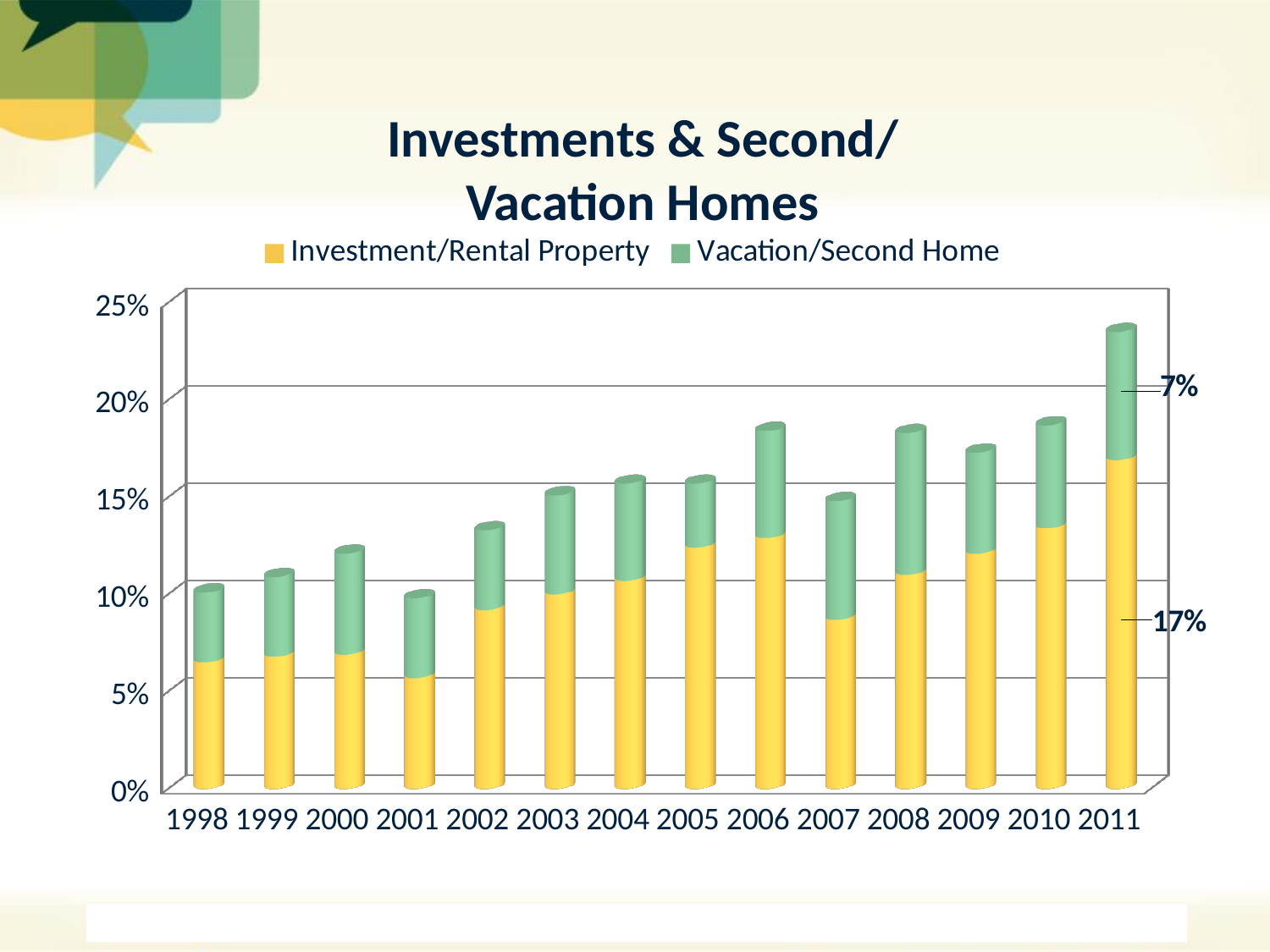
What kind of chart is shown on the slide? Stacked bar chart Which year has the tallest stacked bar overall? 2011 How many series does the legend list? 2 Is the total value for 2006 greater or less than 15%? greater Is the Investment/Rental Property value for 2001 greater or less than 10%? less What is the value for Investment/Rental Property in 2011? 17% Do the total values generally rise or fall from 1998 to 2011? rise How many years are shown on the x axis? 14 Which year has the larger total stacked bar, 2006 or 2007? 2006 Which series is shown in yellow? Investment/Rental Property What is the total height of the stacked bar for 2011? 24% What is the value for Vacation/Second Home in 2011? 7%